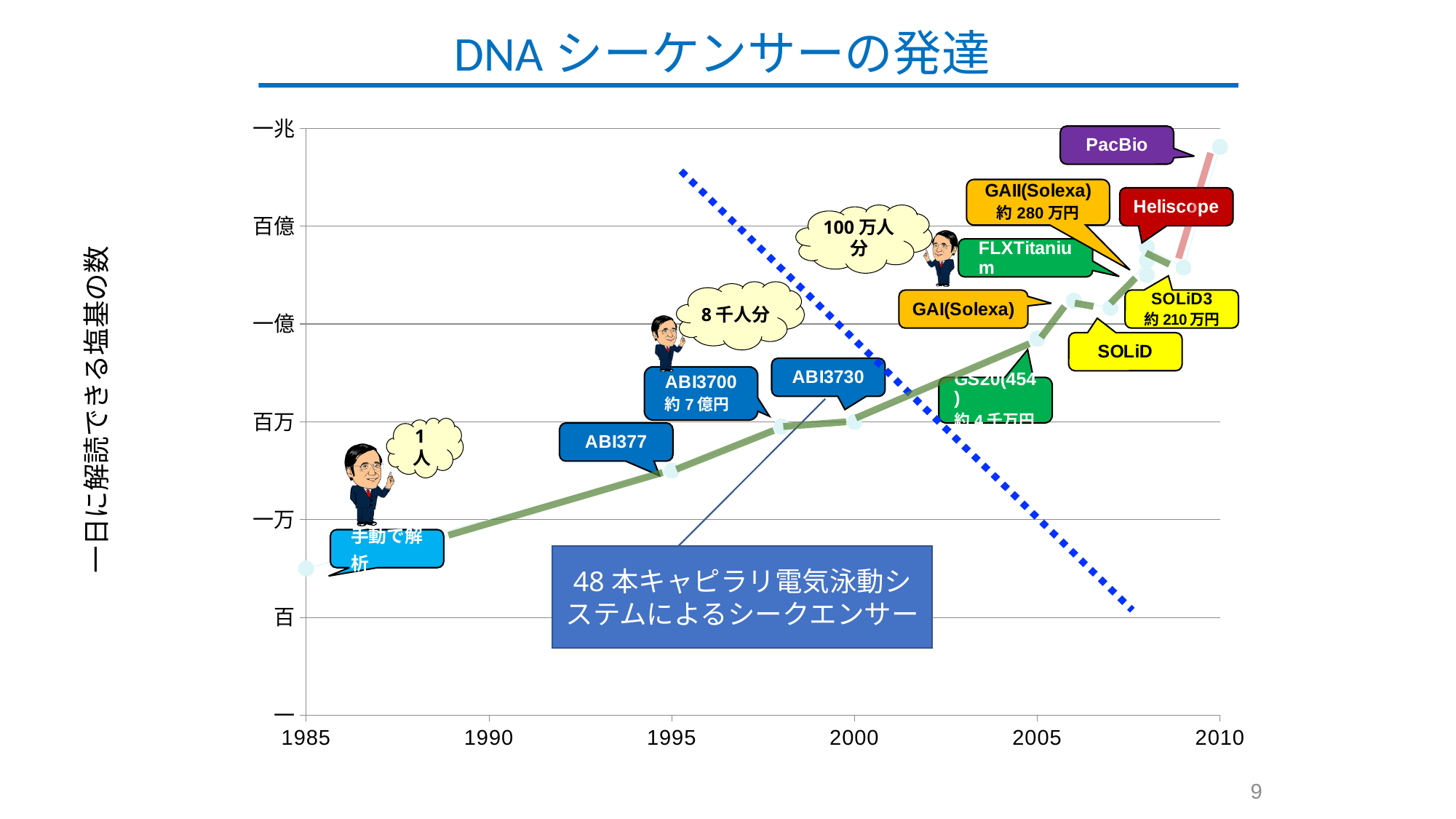
Is the value plotted for 2005 greater or less than 一億? less Which is larger, the value plotted for 2005 or the value plotted for 1995? 2005 Is the highest plotted value (around 2009) greater or less than 百億? greater Is the value plotted for 1995 greater or less than 一万? greater Do the plotted values rise or fall as the year increases along the x axis? rise What is the label on the vertical axis of the chart? 一日に解読できる塩基の数 Which year has the lowest plotted value? 1985 What kind of chart is shown on the slide? line chart What is the title of the chart? DNA シーケンサーの発達